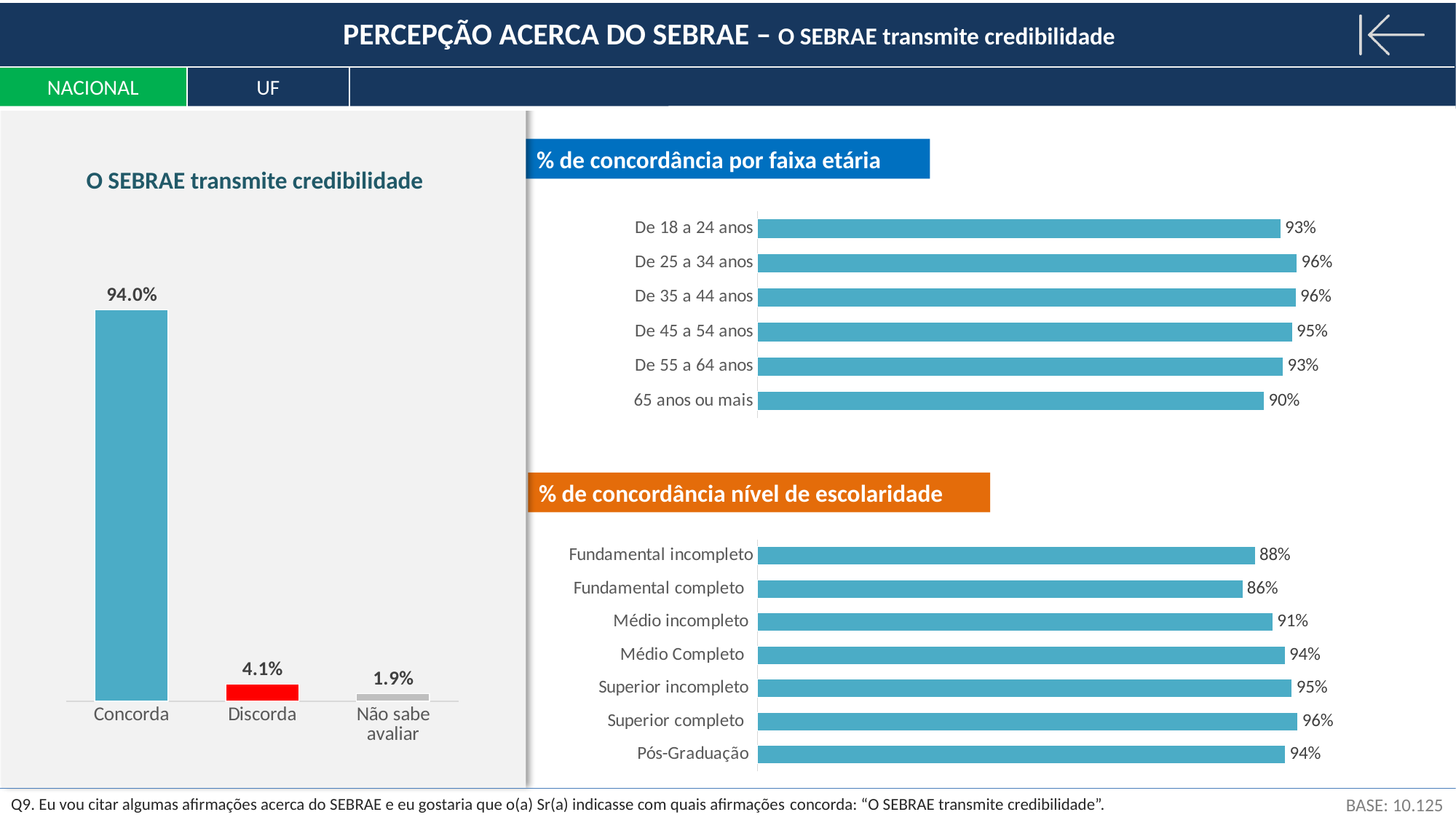
In the chart '% de concordância nível de escolaridade', what is the value for Médio incompleto? 91% In the chart '% de concordância por faixa etária', which age group has the lowest value? 65 anos ou mais In the chart '% de concordância nível de escolaridade', which is larger: Superior completo or Pós-Graduação? Superior completo In the chart '% de concordância por faixa etária', how many age groups are shown? 6 In the chart titled 'O SEBRAE transmite credibilidade', what is the value for Concorda? 94.0% In the chart '% de concordância por faixa etária', what is the difference between De 25 a 34 anos and 65 anos ou mais? 6% In the chart titled 'O SEBRAE transmite credibilidade', how many categories are shown? 3 In the chart '% de concordância nível de escolaridade', which category has the lowest value? Fundamental completo In the chart titled 'O SEBRAE transmite credibilidade', what is the difference between Concorda and Discorda? 89.9% What kind of chart is '% de concordância nível de escolaridade'? Bar chart In the chart '% de concordância por faixa etária', what is the value for De 45 a 54 anos? 95% In the chart titled 'O SEBRAE transmite credibilidade', what is the value for Discorda? 4.1%